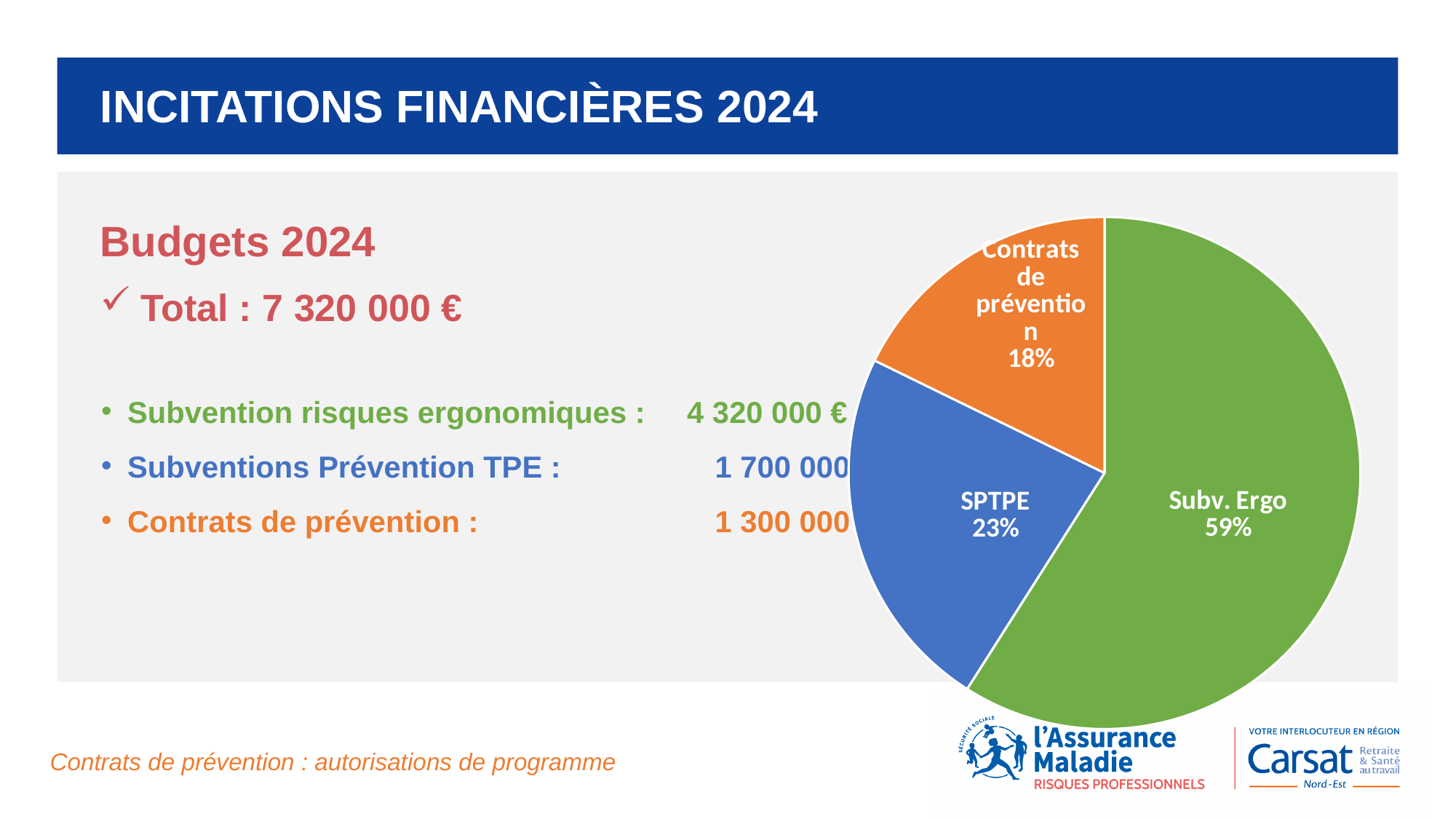
What share of the pie does Contrats de prévention represent? 18% What is the difference in percentage points between the Subv. Ergo slice and the SPTPE slice? 36 Which is larger, the SPTPE slice or the Contrats de prévention slice? SPTPE Which slice of the pie chart is the smallest? Contrats de prévention Which slice of the pie chart is the largest? Subv. Ergo What colour is the SPTPE slice of the pie chart? blue What kind of chart is shown on the slide? pie chart What is the difference in percentage points between the SPTPE slice and the Contrats de prévention slice? 5 What share of the pie does SPTPE represent? 23% What share of the pie does Subv. Ergo represent? 59% How many slices does the pie chart have? 3 What colour is the Subv. Ergo slice of the pie chart? green